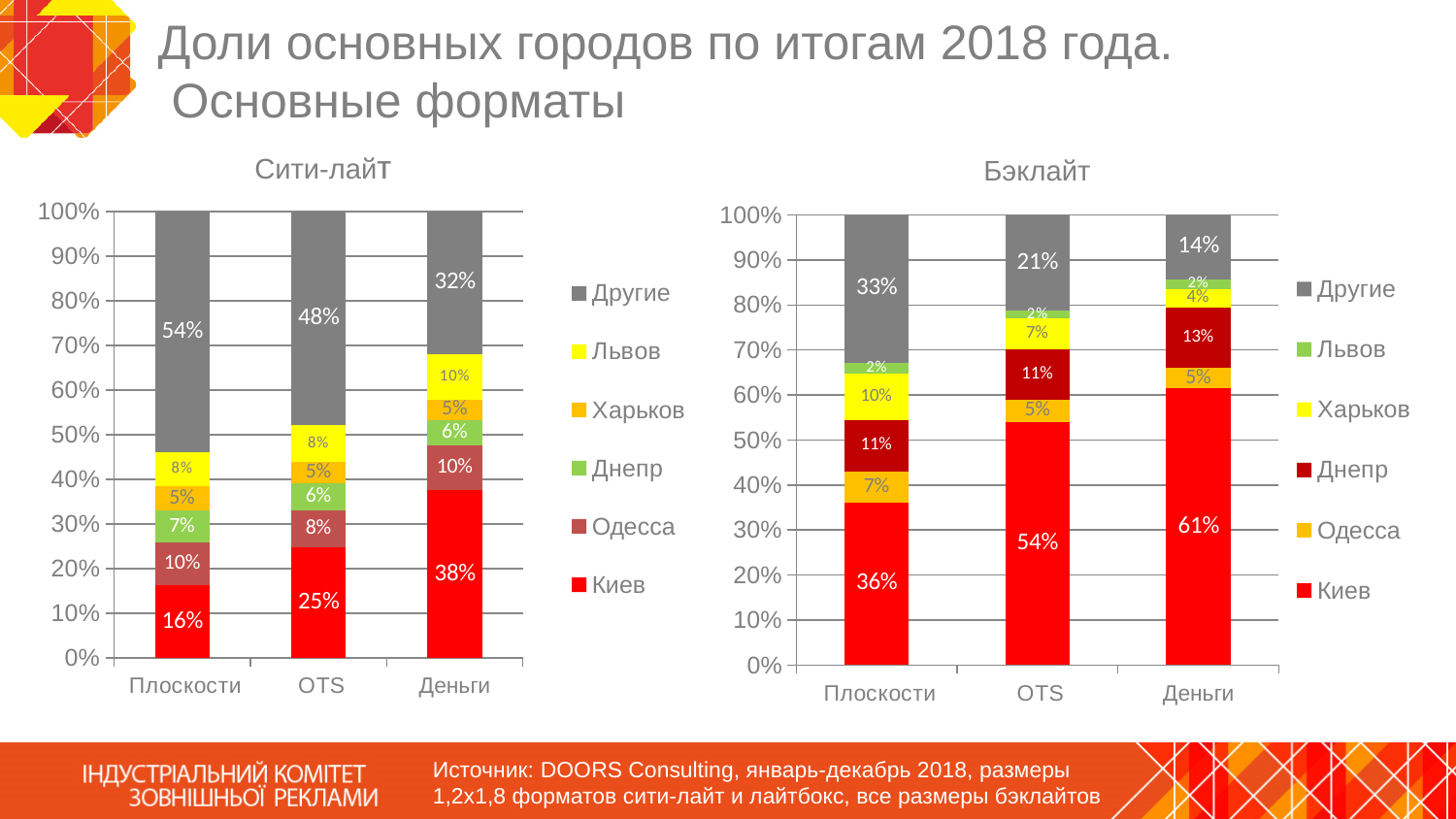
In the Бэклайт chart, which category has the highest value for Киев? Деньги In the Сити-лайт chart, what is the value for Одесса in the OTS bar? 8% In the Бэклайт chart, does the value for Другие rise or fall from Плоскости to Деньги? Fall What kind of chart is the Бэклайт chart? Stacked bar chart How many series does the legend of the Сити-лайт chart list? 6 In the Сити-лайт chart, what is the difference between the Другие values for Плоскости and Деньги? 22% In the Сити-лайт chart, which category has the lowest value for Киев? Плоскости In the Бэклайт chart, what is the value for Другие in the Плоскости bar? 33% In the Бэклайт chart, which is larger: Киев for OTS or Киев for Плоскости? Киев for OTS In the Сити-лайт chart, what is the value for Киев in the Деньги bar? 38% In the Бэклайт chart, what is the value for Днепр in the Деньги bar? 13% How many categories are shown on the x axis of the Бэклайт chart? 3